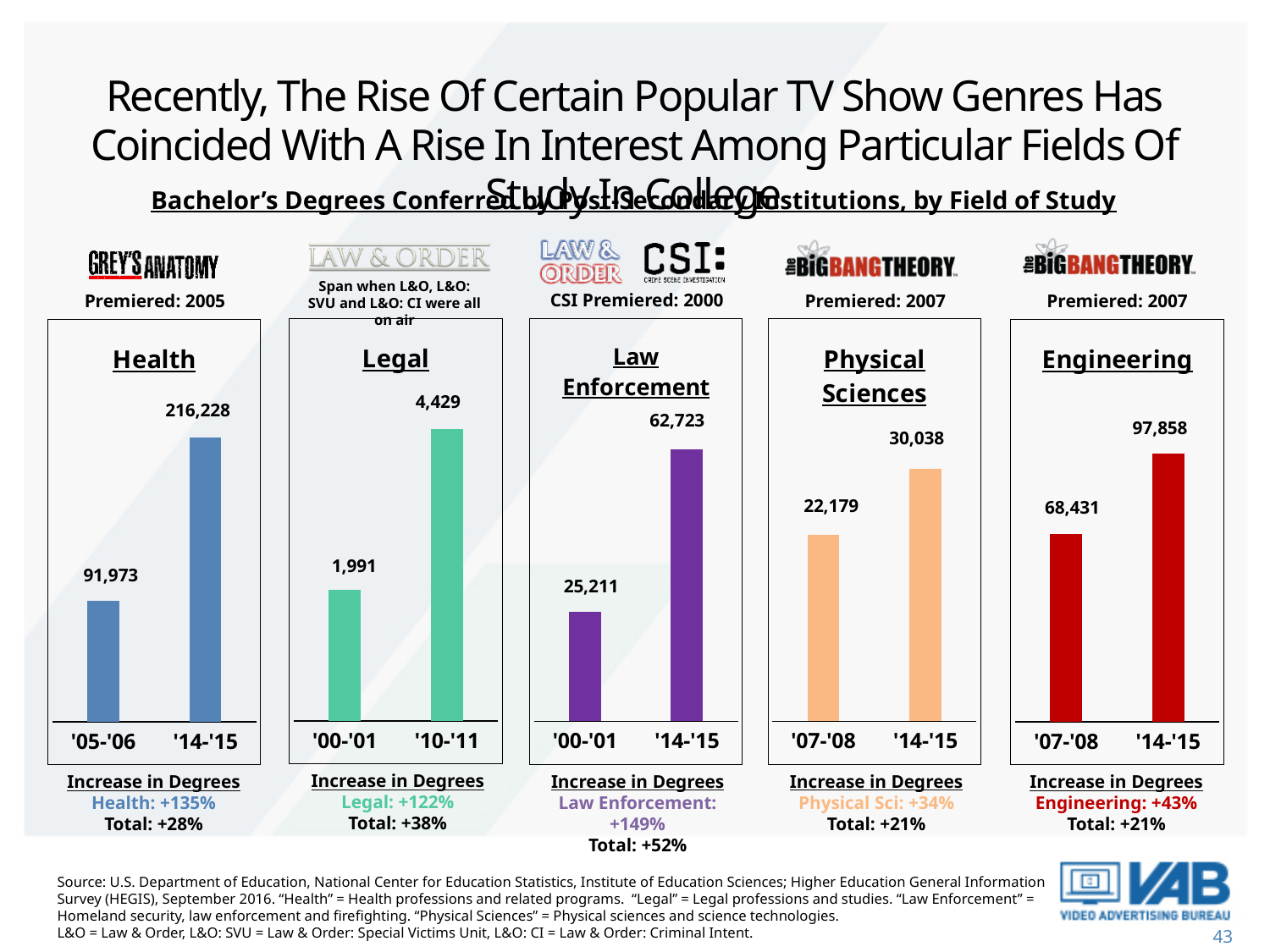
In the Legal chart, do the values rise or fall from '00-'01 to '10-'11? Rise In the Law Enforcement chart, which period has the higher value, '00-'01 or '14-'15? '14-'15 In the Law Enforcement chart, what is the value for '14-'15? 62,723 In the Engineering chart, what is the difference between the '14-'15 and '07-'08 values? 29,427 How many bars are plotted in the Legal chart? 2 In the Engineering chart, what is the value for '14-'15? 97,858 In the Health chart, what is the difference between the '14-'15 and '05-'06 values? 124,255 In the Health chart, what is the value for '14-'15? 216,228 In the Physical Sciences chart, which period has the lowest value? '07-'08 In the Legal chart, what is the value for '00-'01? 1,991 What type of chart is used for the Engineering data? Bar chart In the Physical Sciences chart, what is the value for '07-'08? 22,179